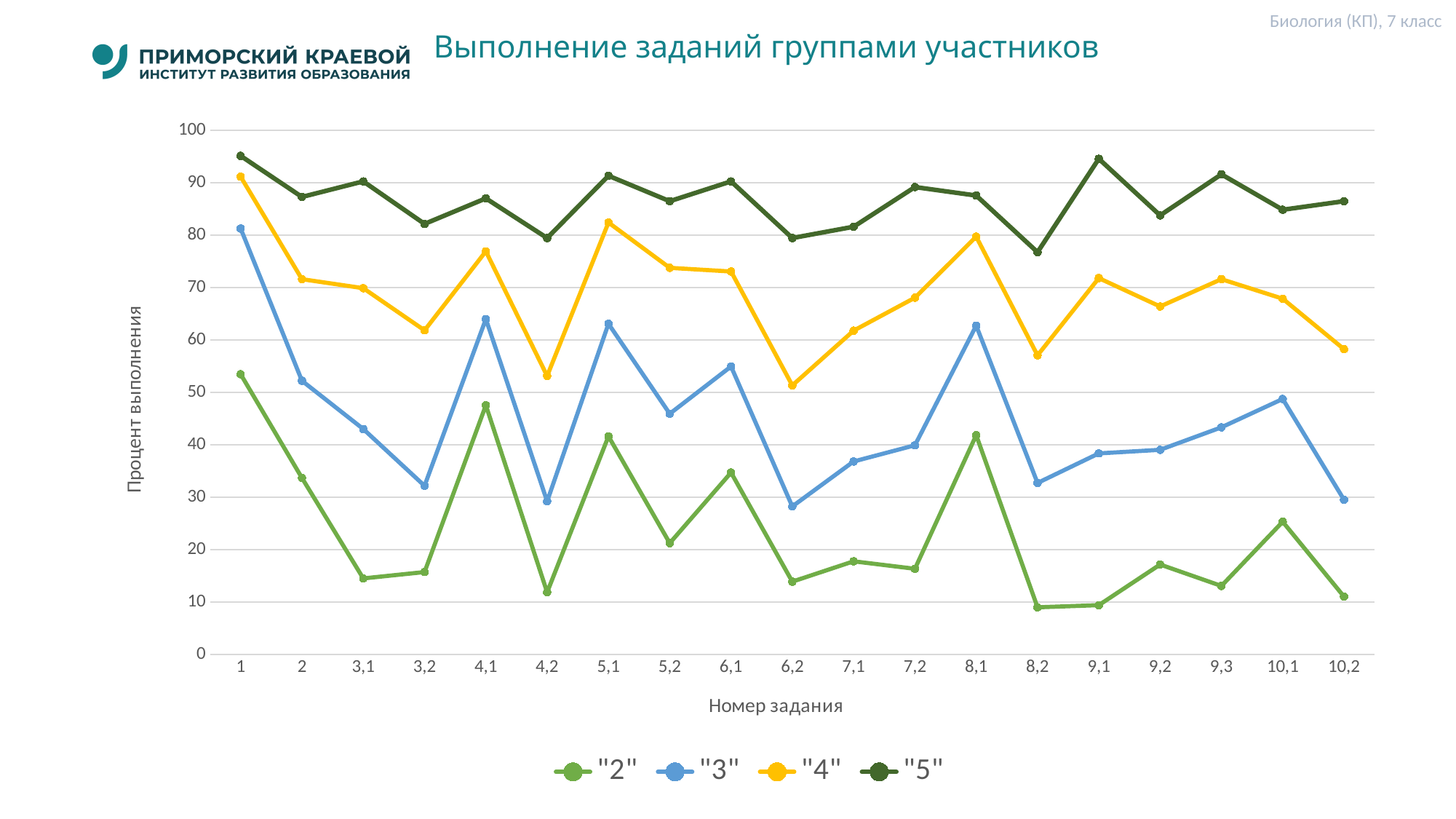
How many task numbers are plotted along the x axis? 19 How many series does the legend list? 4 For series "3", which is larger: the value at task 4,1 or at task 4,2? 4,1 Is the value for series "5" at task 8,2 greater or less than 80? less Do the values for series "3" rise or fall from task 1 to task 3,2? fall Is the value for series "2" at task 4,2 greater or less than 20? less Which task number has the highest value for series "3"? 1 Which task number has the lowest value for series "5"? 8,2 What is the title of the vertical axis? Процент выполнения What kind of chart is shown on the slide? line chart Is the value for series "2" at task 1 greater or less than 50? greater Which task number has the highest value for series "2"? 1